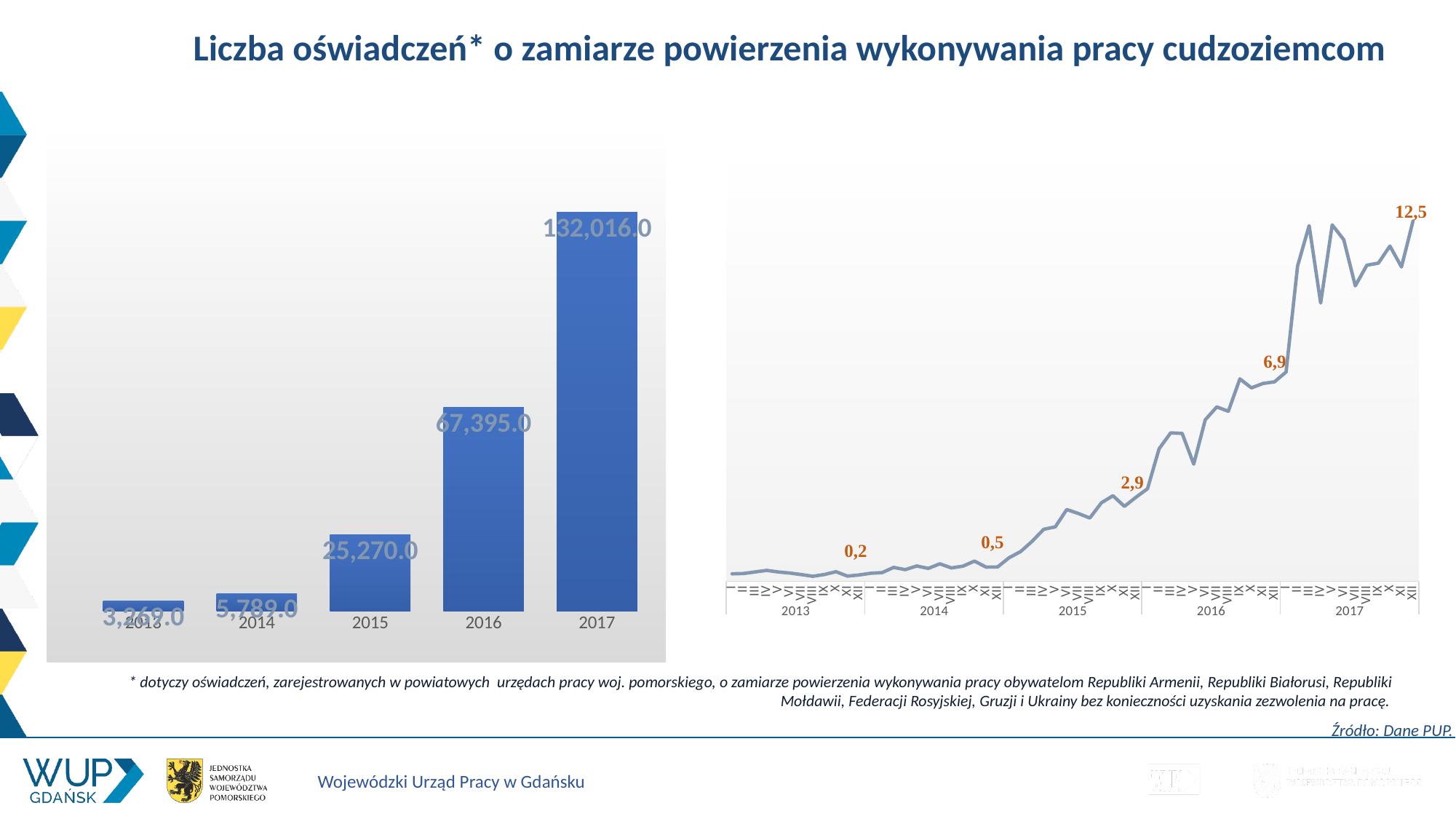
What kind of chart is the chart on the left? bar chart In the bar chart on the left, what is the value for 2016? 67,395.0 What kind of chart is the chart on the right? line chart In the bar chart on the left, which year has the lowest value? 2013 In the bar chart on the left, what is the value for 2014? 5,789.0 In the bar chart on the left, which year has the highest value? 2017 How many bars are shown in the bar chart on the left? 5 In the bar chart on the left, what is the difference between the values for 2017 and 2016? 64,621.0 In the bar chart on the left, do the values rise or fall from 2013 to 2017? rise In the line chart on the right, what is the value of the last labelled point in 2017? 12,5 In the bar chart on the left, what is the value for 2017? 132,016.0 In the bar chart on the left, what is the value for 2015? 25,270.0